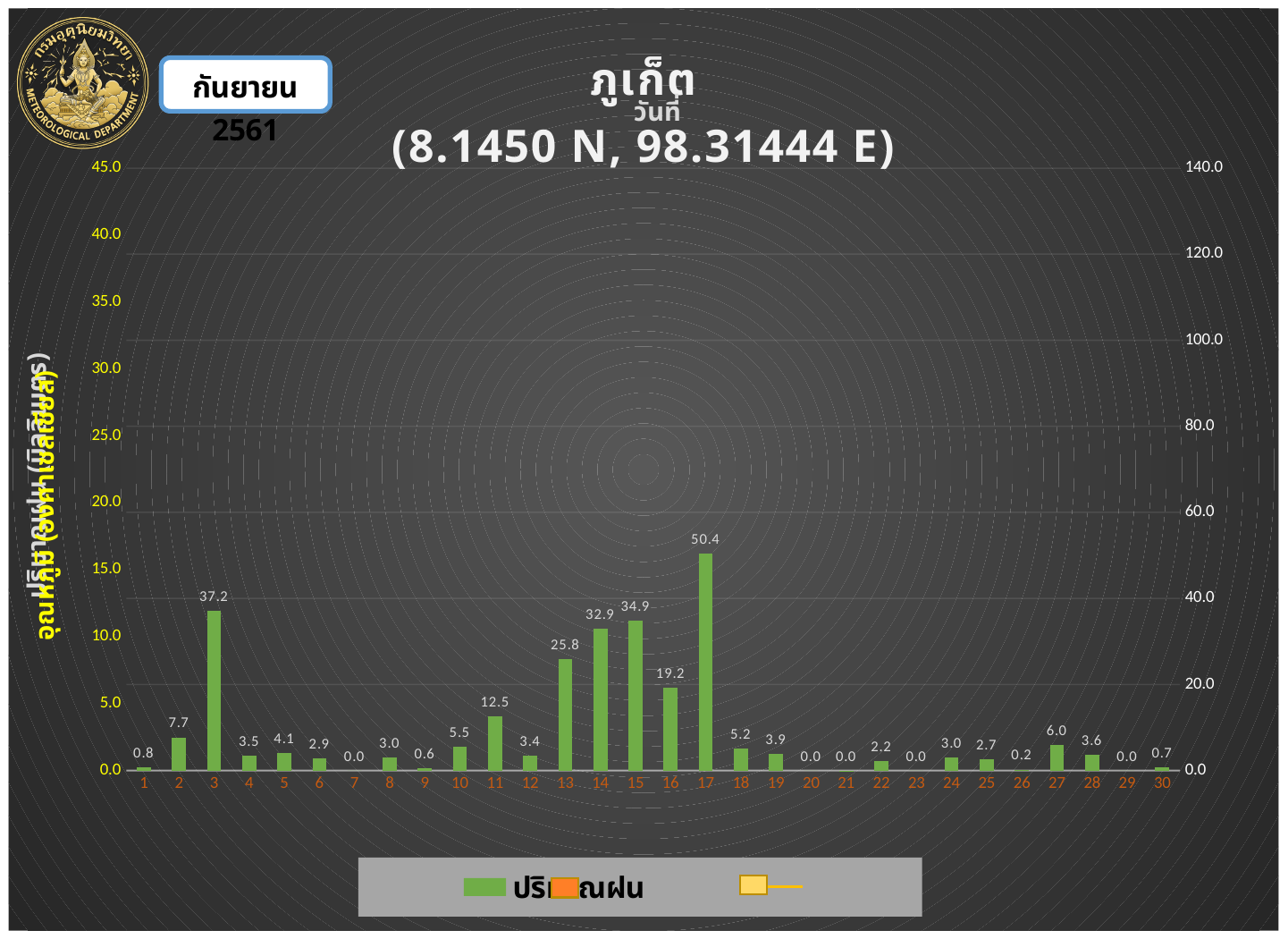
What is the rainfall value shown for day 3? 37.2 What is the rainfall value shown for day 27? 6.0 Which day has the highest rainfall value? 17 Is the rainfall value for day 11 greater or less than 10? greater What is the difference between the rainfall values for day 17 and day 3? 13.2 Which day has the larger rainfall value, day 13 or day 16? 13 What is the difference between the rainfall values for day 15 and day 14? 2.0 Do the rainfall values rise or fall from day 13 to day 15? rise What kind of chart is shown on the slide? bar chart What is the rainfall value shown for day 17? 50.4 What is the rainfall value shown for day 11? 12.5 How many days are shown on the x axis of the chart? 30